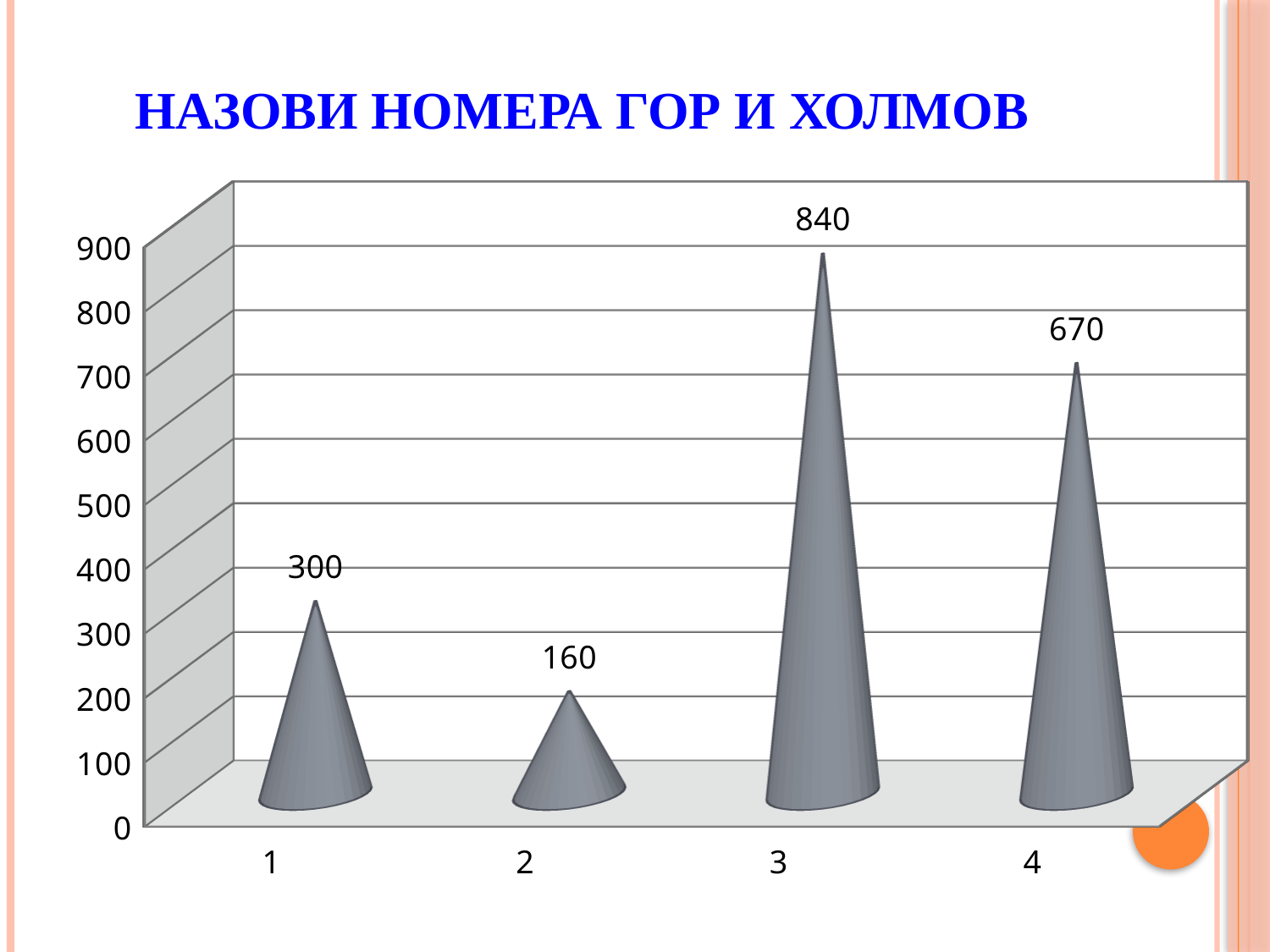
What is the value for category 4? 670 What is the value for category 1? 300 Which is larger, the value for category 1 or the value for category 4? 4 Is the value for category 3 greater or less than 800? greater What is the value for category 3? 840 Which category has the lowest value? 2 Which category has the highest value? 3 What is the value for category 2? 160 What kind of chart is shown on the slide? bar chart How many categories are shown on the chart? 4 What is the difference between the values for category 1 and category 2? 140 What is the difference between the values for category 3 and category 4? 170